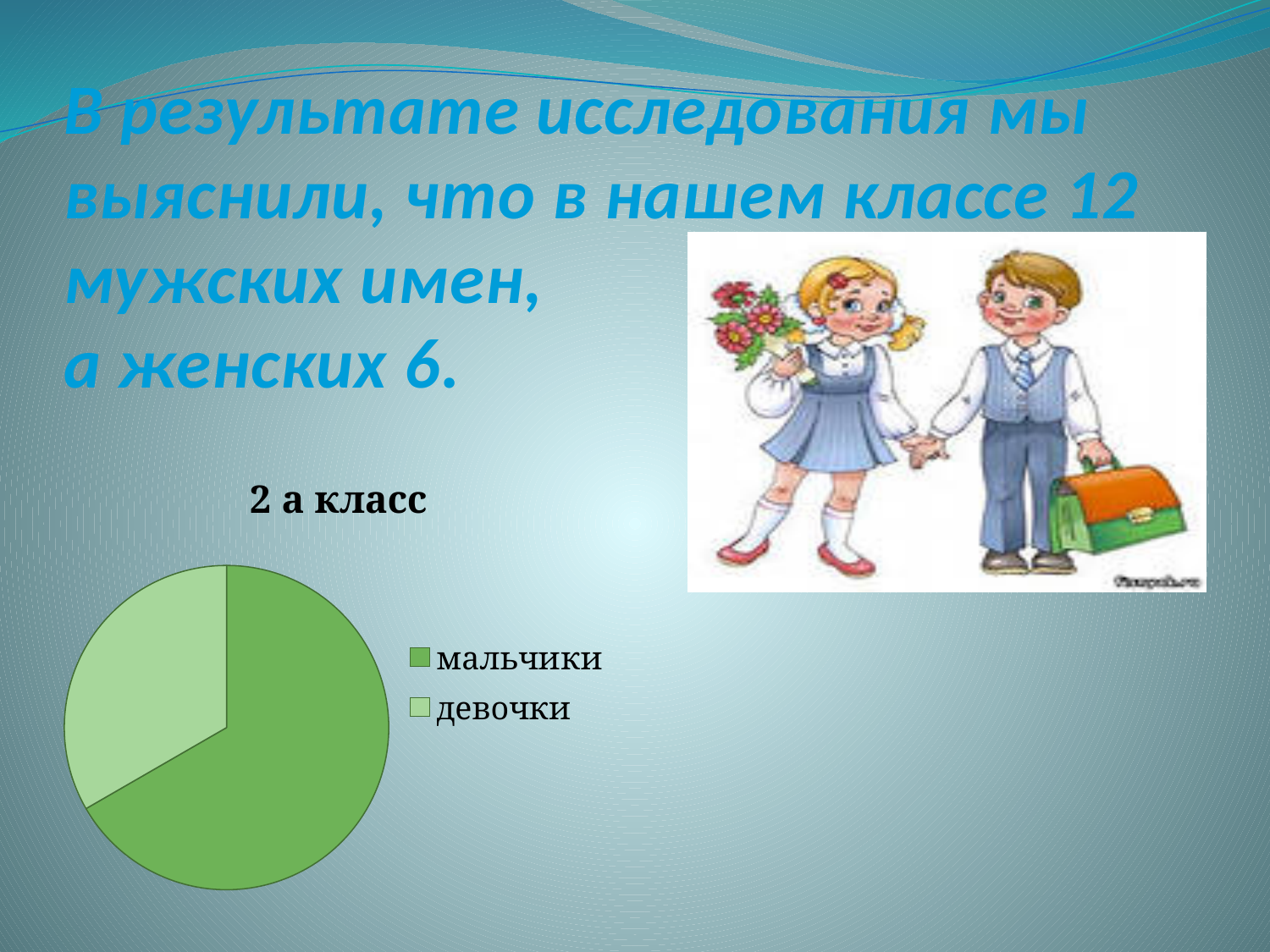
Which legend entry is shown in the lighter green colour? девочки What is the title of the pie chart? 2 а класс How many entries does the legend of the pie chart list? 2 Which category has the smallest slice in the pie chart? девочки Which slice is larger in the pie chart, мальчики or девочки? мальчики What kind of chart is shown on the slide? pie chart Which category has the largest slice in the pie chart? мальчики How many slices does the pie chart have? 2